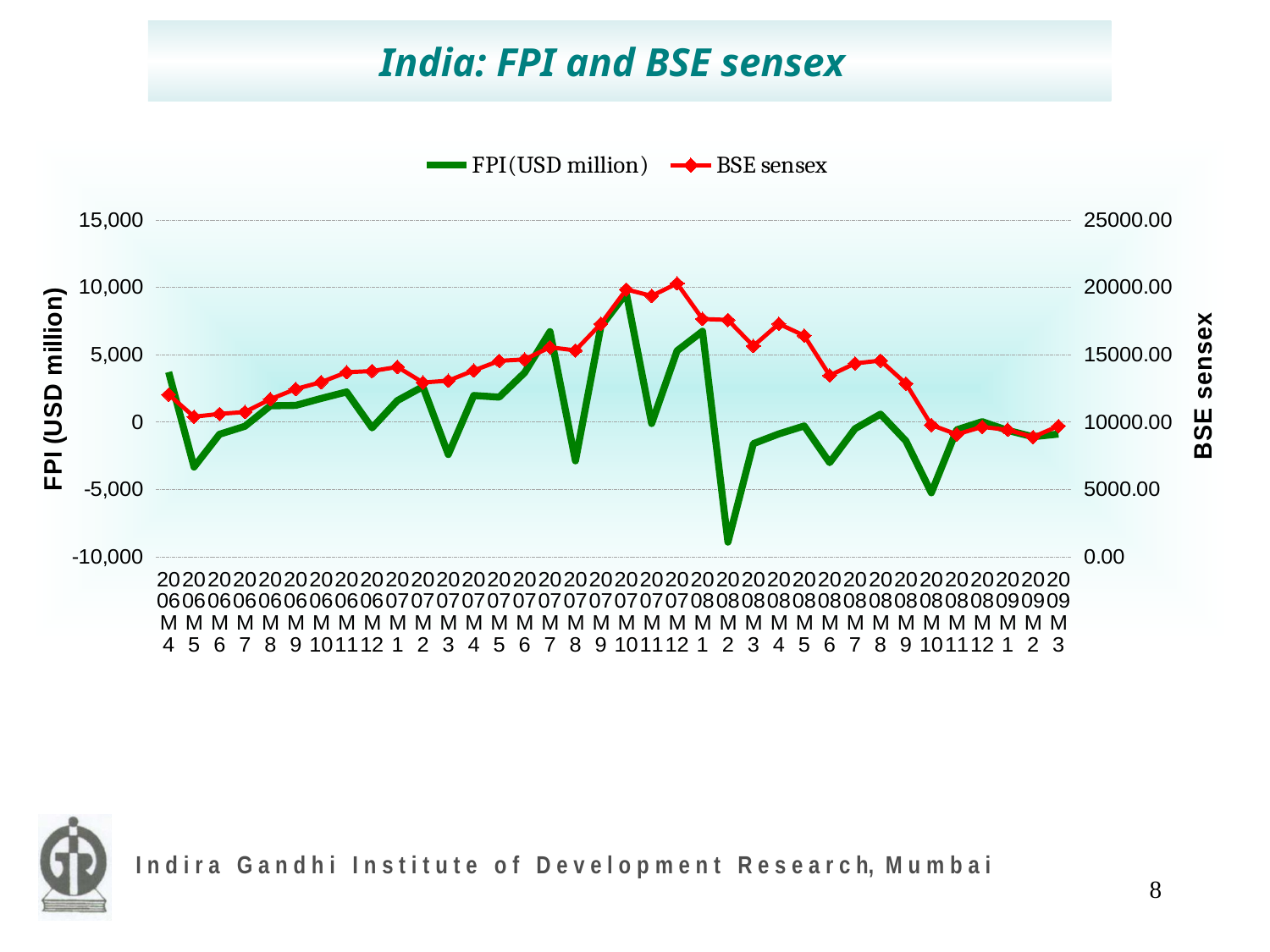
In which month does the FPI (USD million) series reach its lowest value? 2008 M2 Is the BSE sensex value for 2006 M5 greater or less than 15000.00? less Is the FPI (USD million) value for 2007 M10 greater or less than 5,000? greater How many series does the legend list? 2 In which month does the FPI (USD million) series reach its highest value? 2007 M10 Does the BSE sensex series rise or fall from 2008 M1 to 2009 M3? fall Is the BSE sensex value for 2007 M12 greater or less than 15000.00? greater Which series is plotted against the right-hand axis? BSE sensex What is the title of the chart? India: FPI and BSE sensex What kind of chart is shown on the slide? Line chart How many monthly data points are plotted along the x axis? 36